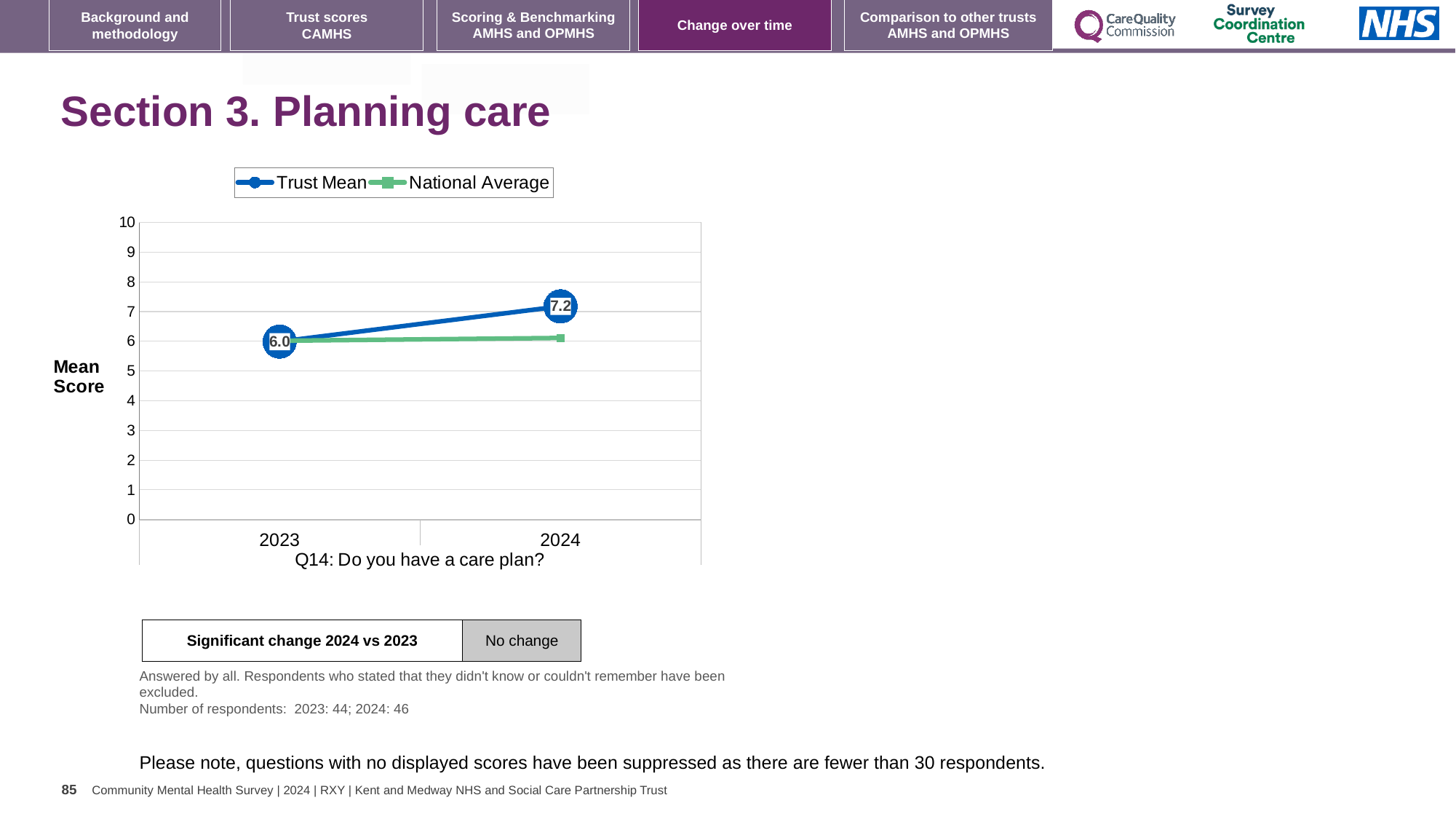
How many years are shown on the x axis? 2 By how much did the Trust Mean score change from 2023 to 2024? 1.2 Is the National Average value for 2024 greater or less than 7? less Is the National Average value for 2023 greater or less than 5? greater What is the Trust Mean score for 2023? 6.0 What is the Trust Mean score for 2024? 7.2 In 2024, which is higher, the Trust Mean or the National Average? Trust Mean What question is the chart about, as labelled on the x axis? Q14: Do you have a care plan? How many series does the legend list? 2 Does the Trust Mean line rise or fall from 2023 to 2024? rise Which year has the higher Trust Mean score, 2023 or 2024? 2024 What kind of chart is shown on the slide? line chart